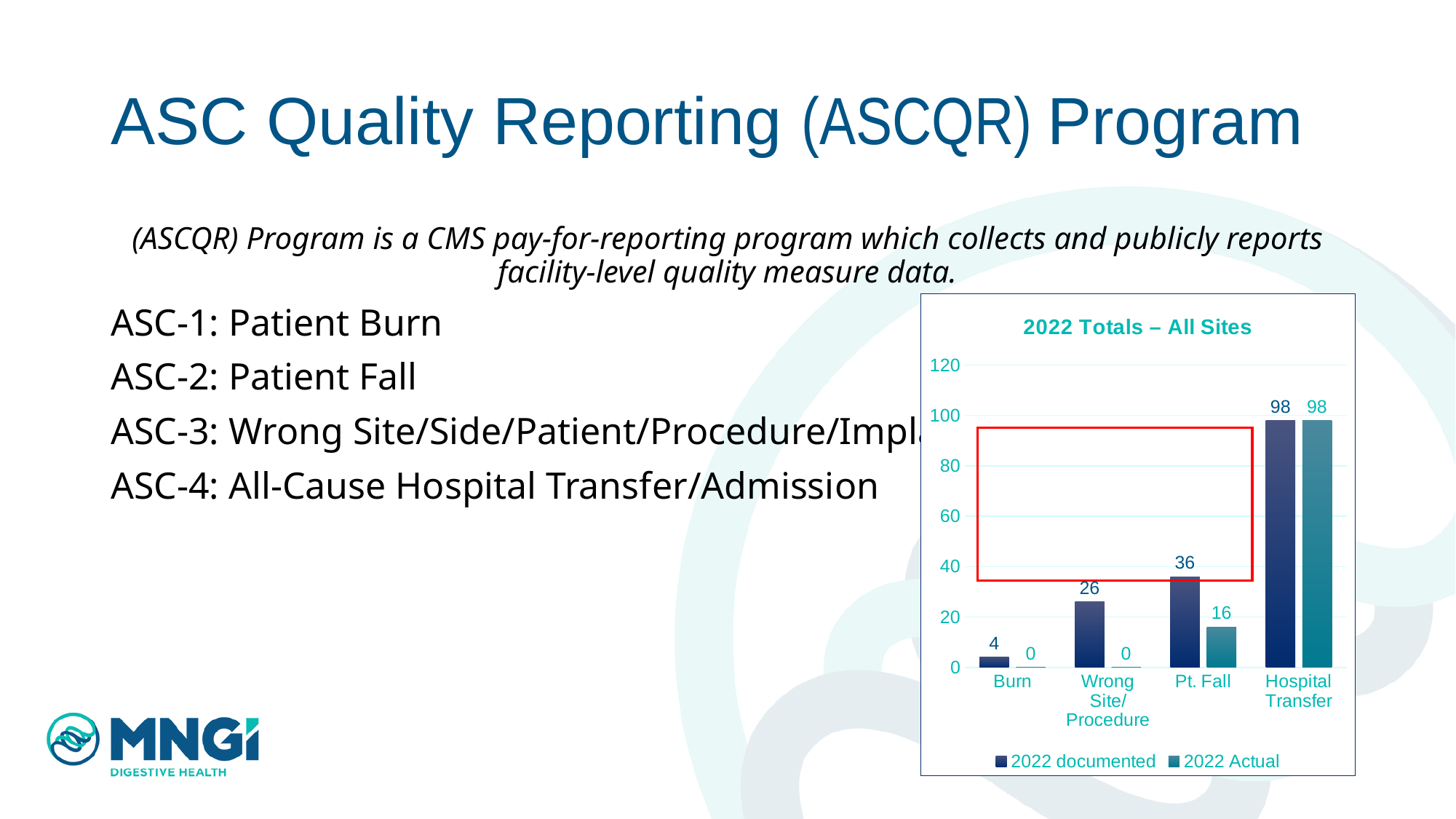
What is the 2022 documented value for Wrong Site/Procedure? 26 What kind of chart is shown on the slide? Bar chart What is the 2022 documented value for Pt. Fall? 36 What is the difference between the 2022 documented and 2022 Actual values for Pt. Fall? 20 Which is larger for Wrong Site/Procedure: the 2022 documented value or the 2022 Actual value? 2022 documented Which category has the highest 2022 documented value? Hospital Transfer How many categories are shown on the x axis? 4 How many series does the legend list? 2 What is the 2022 Actual value for Hospital Transfer? 98 Which category has the lowest 2022 documented value? Burn What is the title of the chart? 2022 Totals – All Sites What is the 2022 Actual value for Burn? 0